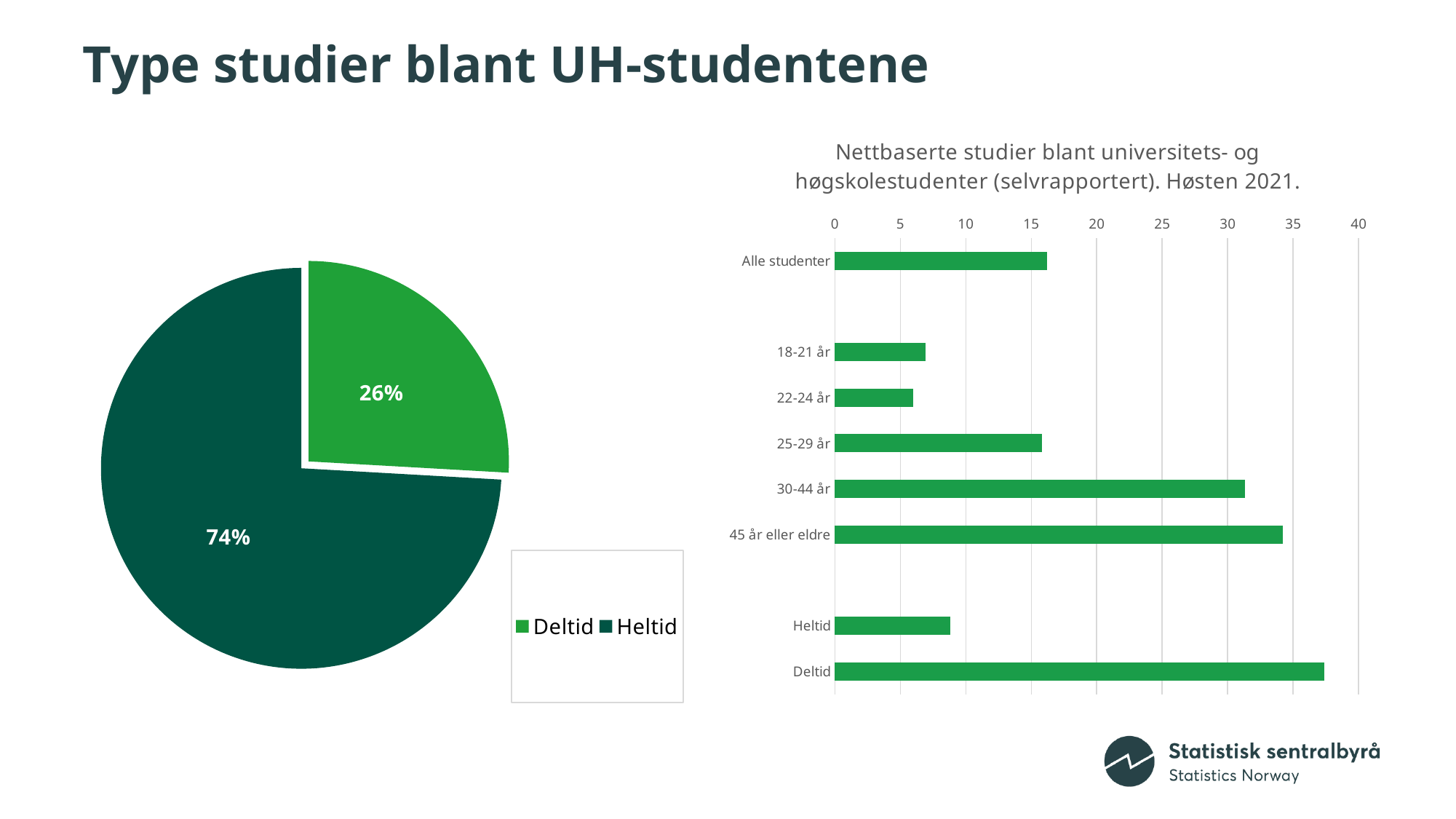
In the bar chart on the right, how many categories are plotted? 8 In the bar chart on the right, is the value for Heltid greater or less than 10? less How many entries does the legend of the pie chart on the left list? 2 In the bar chart on the right, is the value for Deltid greater or less than 35? greater In the bar chart on the right, which category has the highest value? Deltid In the bar chart on the right, is the value for 30-44 år greater or less than 30? greater In the pie chart on the left, which slice is larger, Deltid or Heltid? Heltid In the pie chart on the left, what share is labelled for Heltid? 74% In the pie chart on the left, what share is labelled for Deltid? 26% What kind of chart is the chart on the right of the slide? Bar chart In the bar chart on the right, which is larger, the value for 45 år eller eldre or for 30-44 år? 45 år eller eldre